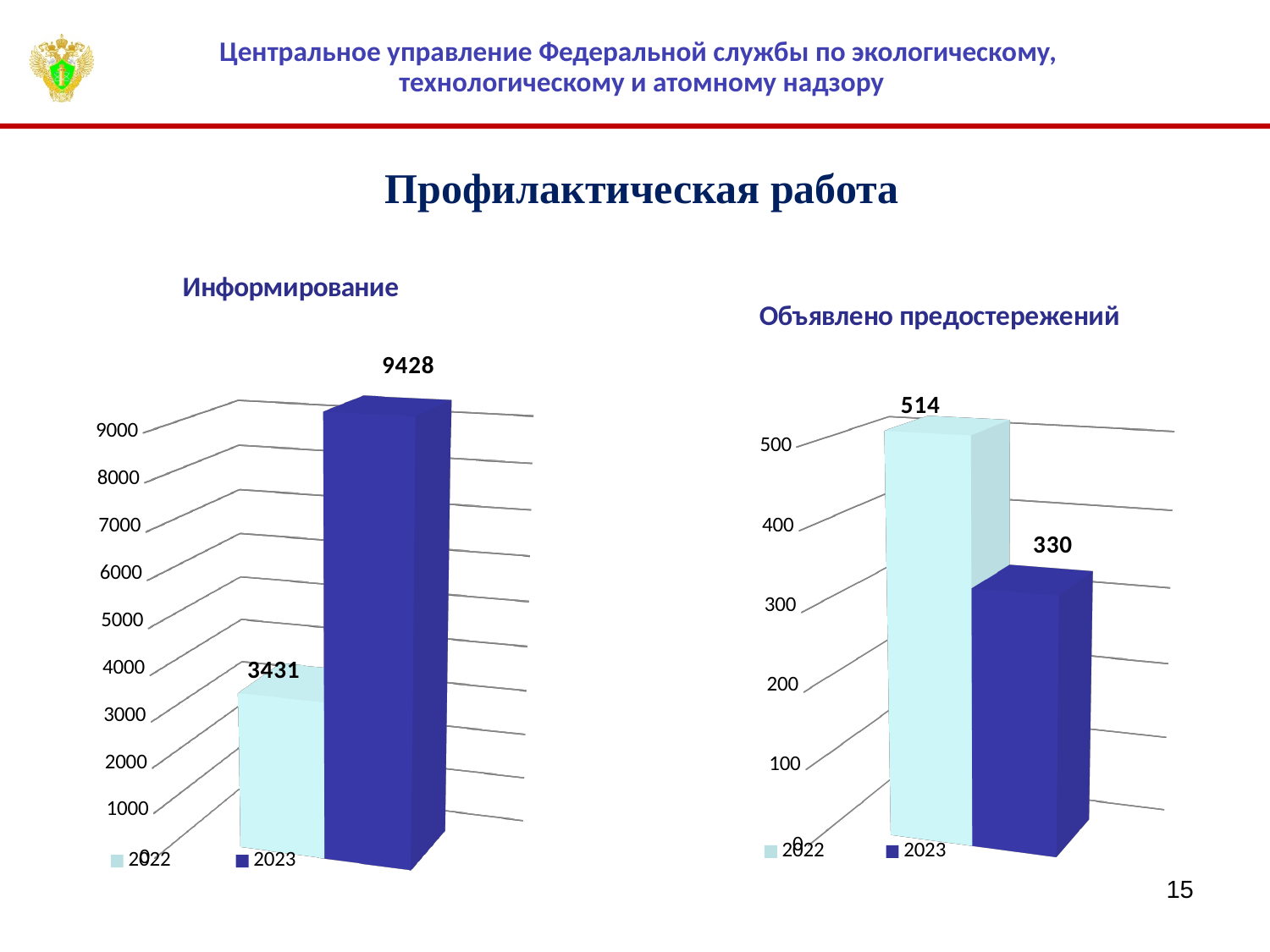
What kind of chart is the 'Объявлено предостережений' chart? bar chart In the 'Информирование' chart, which year has the higher value? 2023 In the 'Объявлено предостережений' chart, which year has the lower value? 2023 In the 'Объявлено предостережений' chart, what is the difference between the 2022 and 2023 values? 184 In the 'Объявлено предостережений' chart, is the value for 2022 greater or less than 500? greater How many series does the legend of the 'Информирование' chart list? 2 In the 'Объявлено предостережений' chart, what is the value for 2022? 514 In the 'Объявлено предостережений' chart, do the values rise or fall from 2022 to 2023? fall In the 'Информирование' chart, what is the value for 2023? 9428 In the 'Информирование' chart, what is the value for 2022? 3431 In the 'Информирование' chart, what is the difference between the 2023 and 2022 values? 5997 In the 'Объявлено предостережений' chart, what is the value for 2023? 330